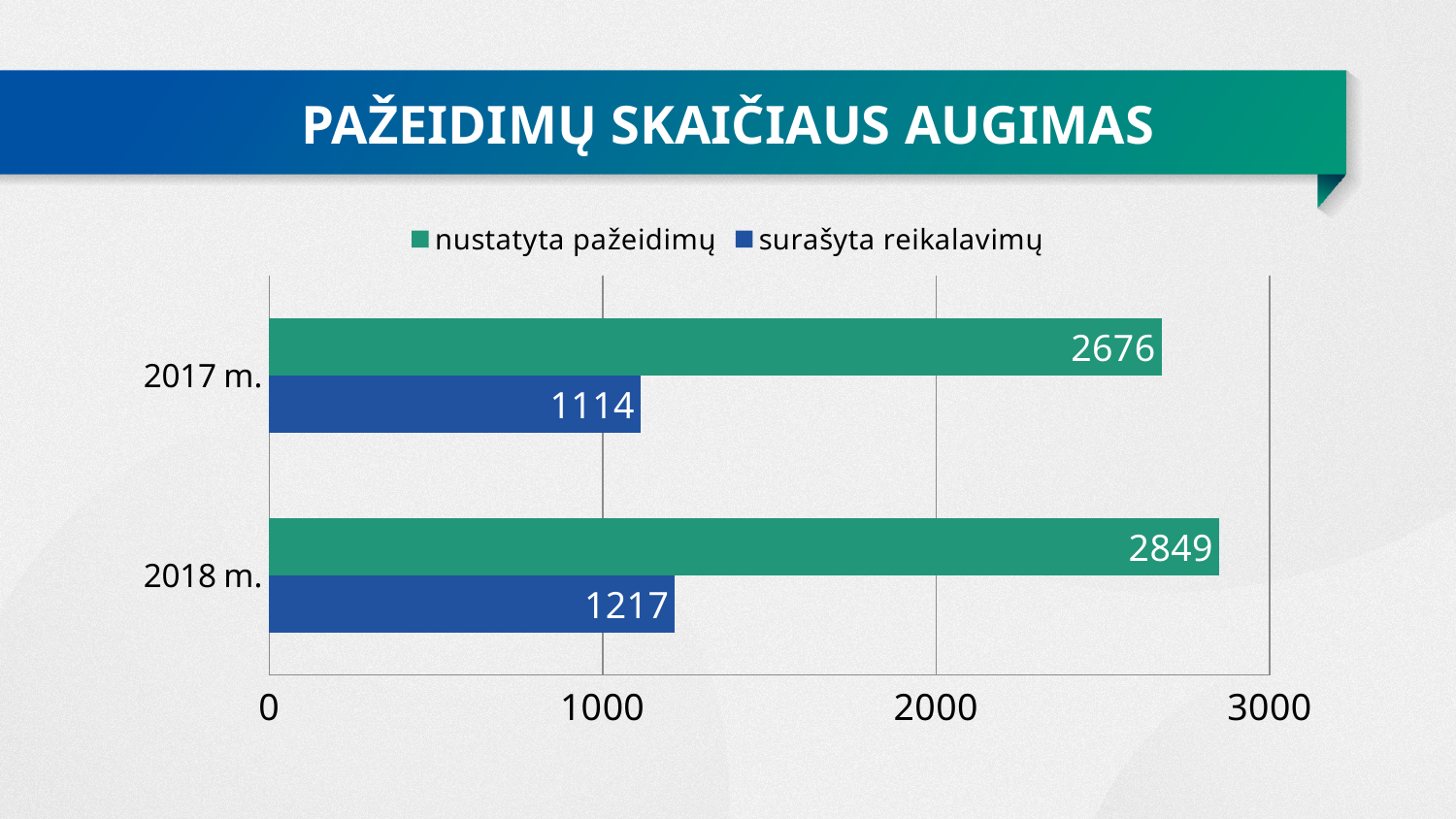
What is the value of 'nustatyta pažeidimų' for 2017 m.? 2676 Which year has the lower value for 'surašyta reikalavimų'? 2017 m. What type of chart is shown on the slide? Bar chart Which year has the higher value for 'nustatyta pažeidimų'? 2018 m. How many series does the legend list? 2 What is the value of 'surašyta reikalavimų' for 2017 m.? 1114 Is the value for 'nustatyta pažeidimų' in 2017 m. greater or less than 2000? greater How many year categories are shown on the chart? 2 What is the value of 'surašyta reikalavimų' for 2018 m.? 1217 What is the difference between 'nustatyta pažeidimų' and 'surašyta reikalavimų' in 2018 m.? 1632 What is the difference between 'nustatyta pažeidimų' in 2018 m. and 2017 m.? 173 Which is larger: 'surašyta reikalavimų' in 2018 m. or 'surašyta reikalavimų' in 2017 m.? 2018 m.